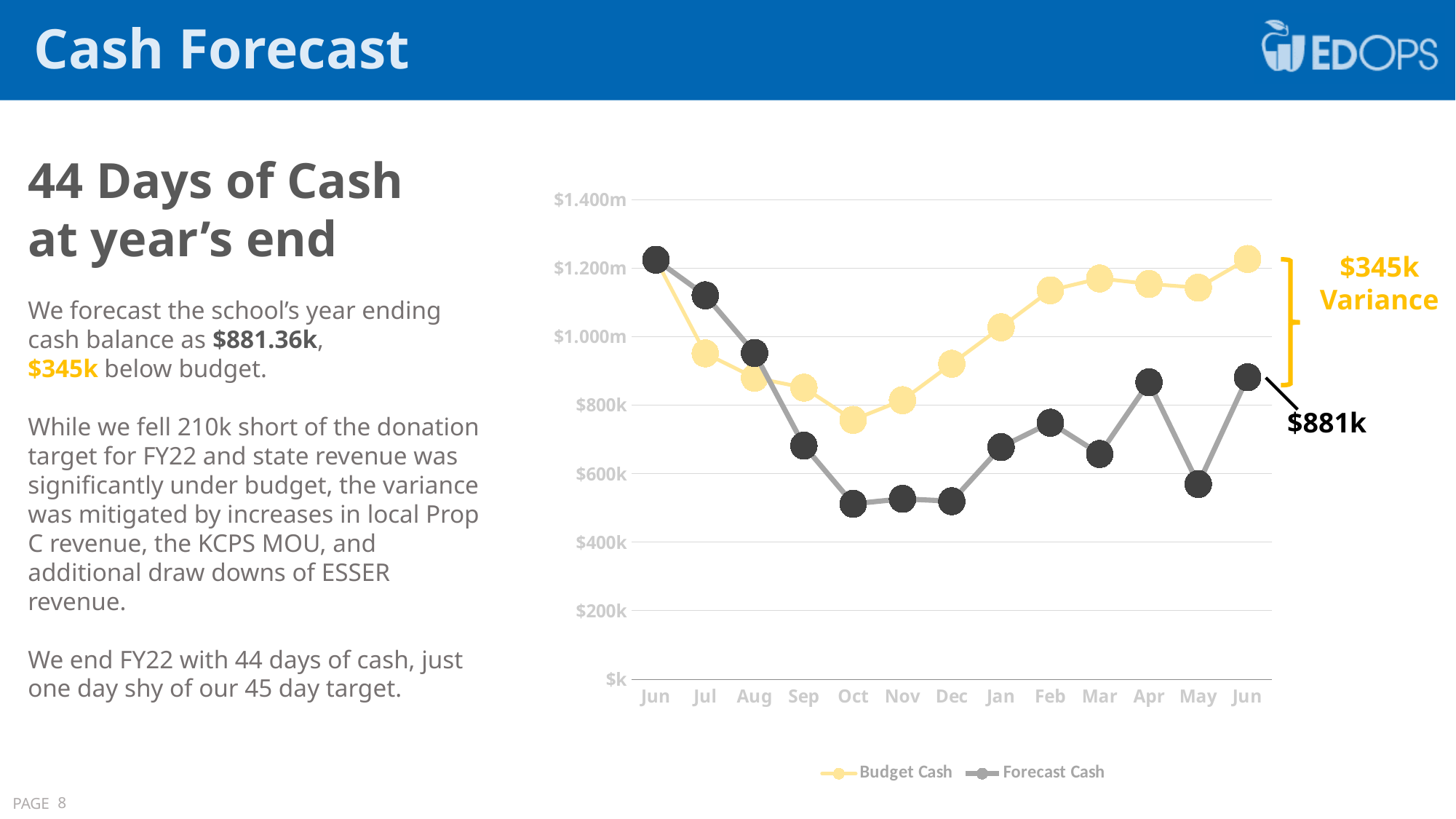
Is the Budget Cash value for Feb greater or less than $1.000m? greater In Oct, which is larger: Budget Cash or Forecast Cash? Budget Cash What variance between Budget Cash and Forecast Cash is annotated at the end of the chart? $345k What kind of chart is shown on the slide? line chart Does Budget Cash rise or fall from Oct to the final Jun? rise In which month is Forecast Cash at its highest? Jun (first) What are the two series named in the chart legend? Budget Cash and Forecast Cash Is the Forecast Cash value for Oct greater or less than $600k? less In which month is Budget Cash at its lowest? Oct How many months are shown along the x axis of the chart? 13 What is the Forecast Cash value labelled at the final Jun point on the chart? $881k How many series does the chart legend list? 2